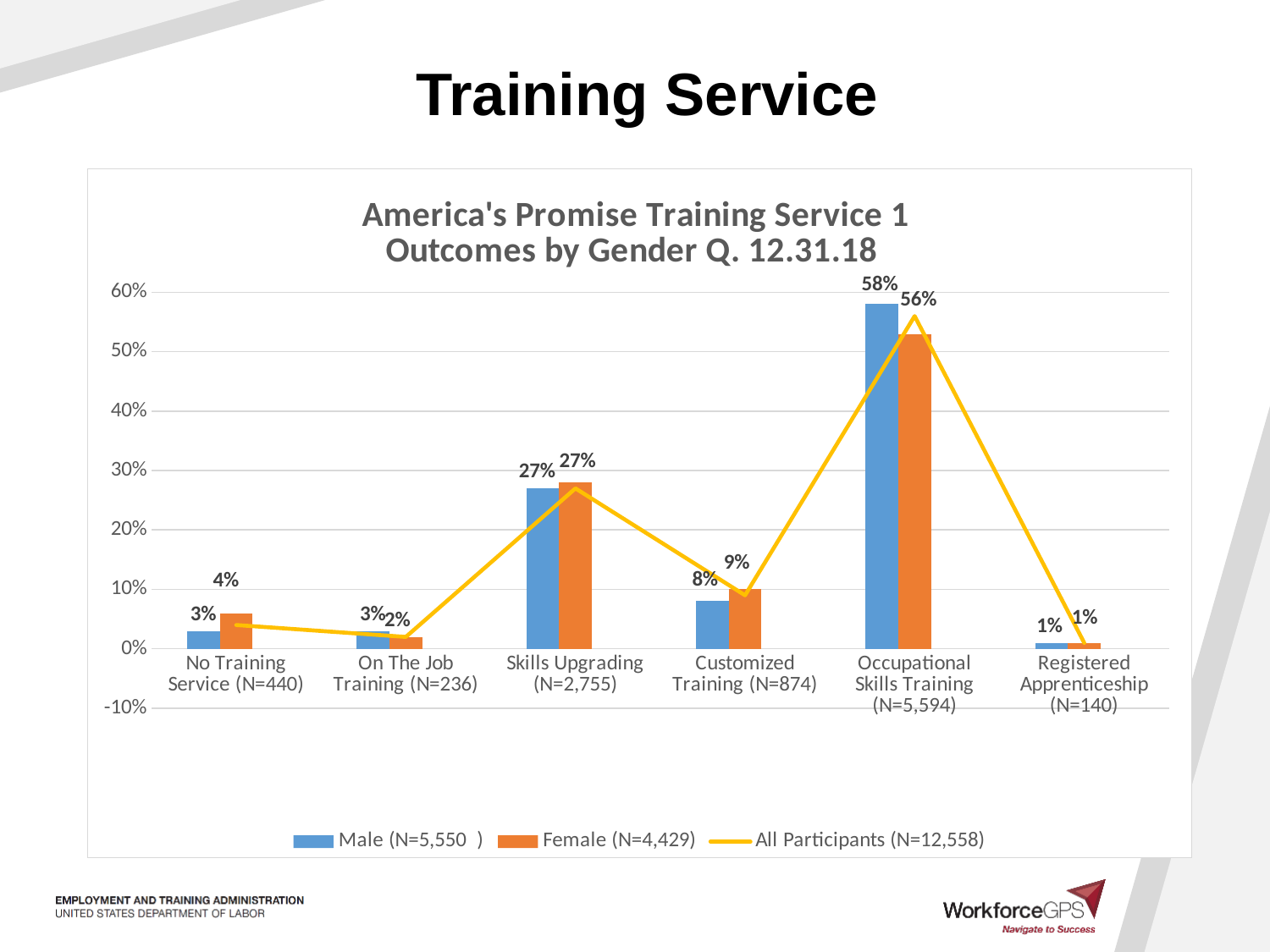
Which is larger for On The Job Training (N=236), the Male value or the Female value? Male What is the Male value for Occupational Skills Training (N=5,594)? 58% What kind of chart is used for the Male and Female series? Bar chart How many series does the legend list? 3 Which category has the highest Male value? Occupational Skills Training (N=5,594) What is the title of the chart? America's Promise Training Service 1 Outcomes by Gender Q. 12.31.18 How many training service categories are shown on the x axis? 6 Is the All Participants value for Occupational Skills Training (N=5,594) greater or less than 50%? greater Which category has the lowest Female value? Registered Apprenticeship (N=140)